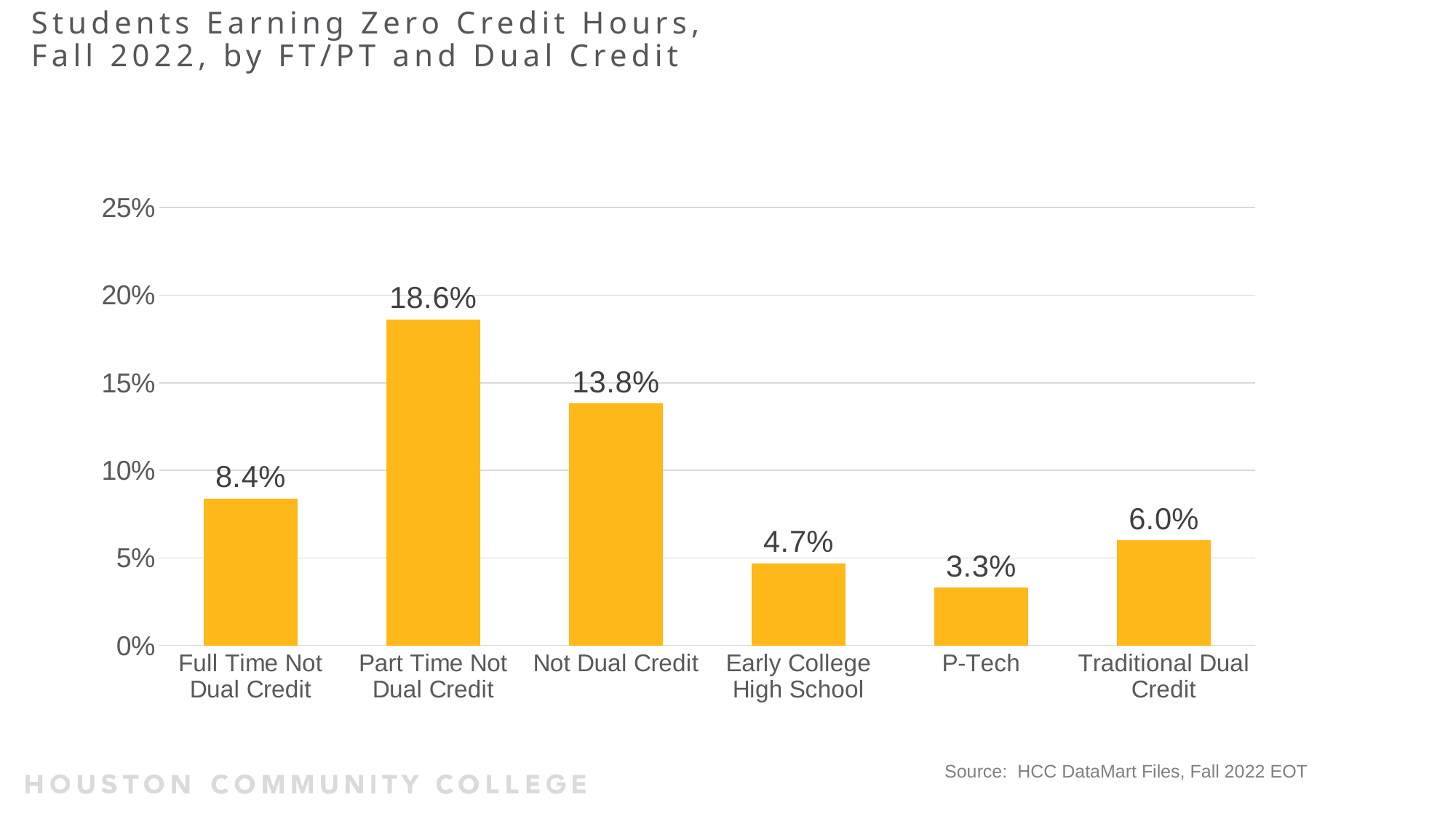
What is the title of the chart? Students Earning Zero Credit Hours, Fall 2022, by FT/PT and Dual Credit Is the value for Not Dual Credit greater or less than 10%? greater What is the value shown for Early College High School? 4.7% Which category has the lowest percentage of students earning zero credit hours? P-Tech What is the difference between the Part Time Not Dual Credit and Full Time Not Dual Credit values? 10.2% How many categories are shown on the x axis? 6 Which category has the highest percentage of students earning zero credit hours? Part Time Not Dual Credit What percentage of Part Time Not Dual Credit students earned zero credit hours? 18.6% Which is larger, the value for Early College High School or the value for Traditional Dual Credit? Traditional Dual Credit What is the value shown for Traditional Dual Credit? 6.0% What kind of chart is shown on the slide? Bar chart What is the difference between the Not Dual Credit and Traditional Dual Credit values? 7.8%